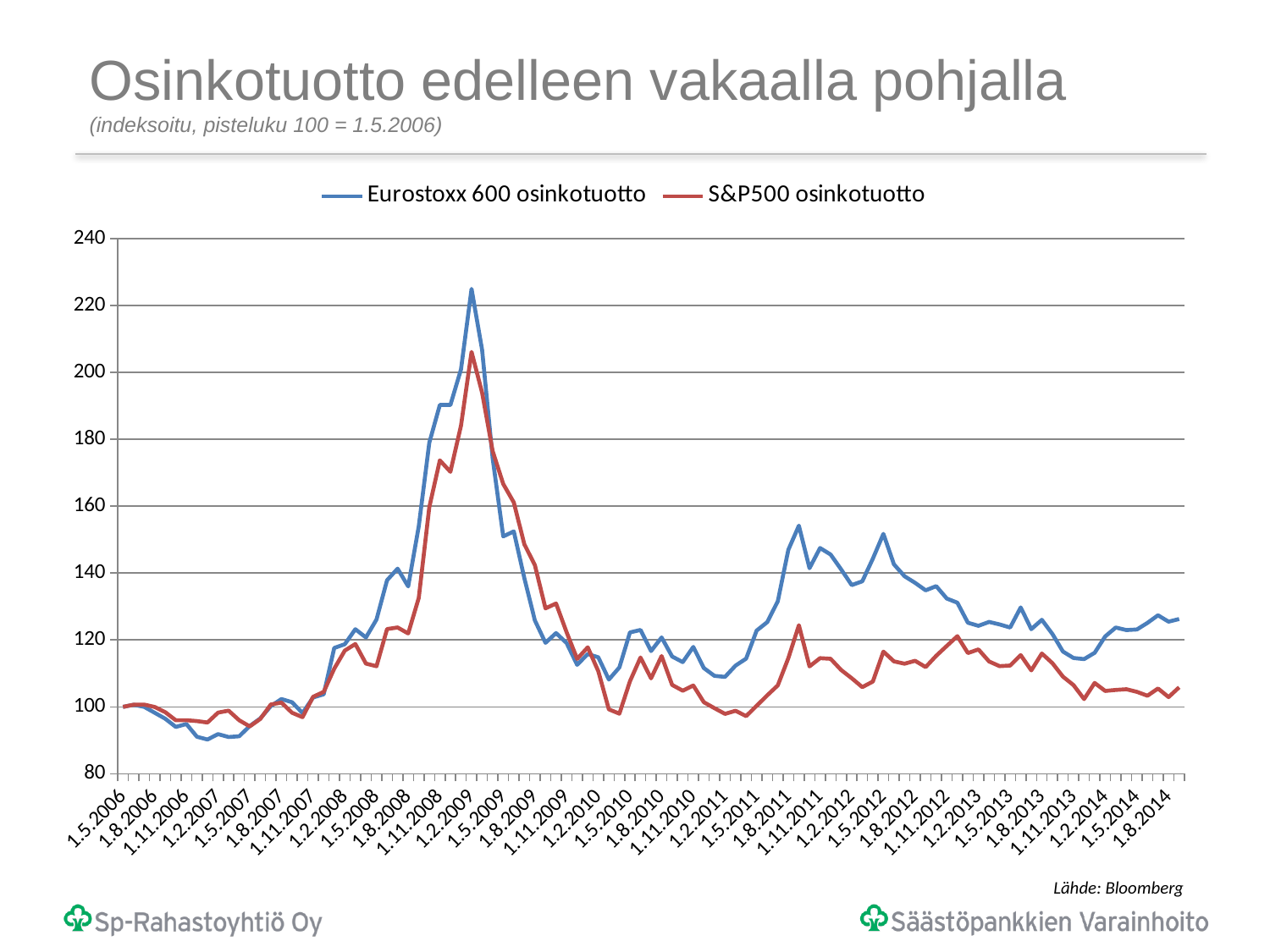
At 1.8.2011, which series has the higher value, Eurostoxx 600 osinkotuotto or S&P500 osinkotuotto? Eurostoxx 600 osinkotuotto What kind of chart is shown on the slide? line chart Is the value for S&P500 osinkotuotto at 1.8.2014 greater or less than 120? less Is the peak value of S&P500 osinkotuotto around 1.2.2009 greater or less than 200? greater Does the Eurostoxx 600 osinkotuotto series rise or fall between 1.2.2009 and 1.2.2010? fall How many series does the legend list? 2 Is the value for Eurostoxx 600 osinkotuotto at 1.8.2014 greater or less than 120? greater What source is cited for the chart? Bloomberg What is the index value of both series at 1.5.2006? 100 Which series reaches the higher peak value over the whole period? Eurostoxx 600 osinkotuotto What is the title of the chart on the slide? Osinkotuotto edelleen vakaalla pohjalla